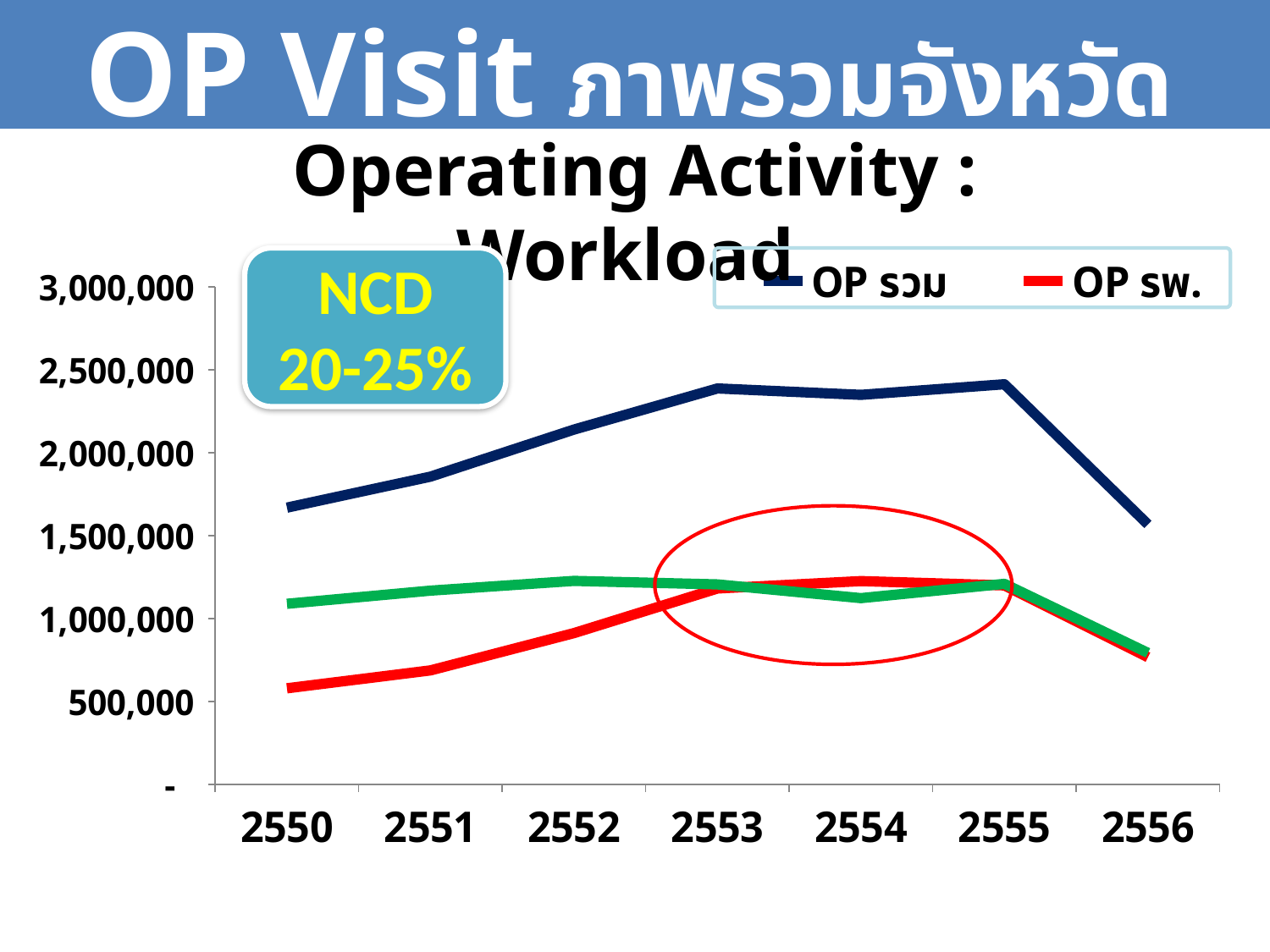
What kind of chart is shown on the slide? line chart Is the value for OP รวม in 2550 greater or less than 1,500,000? greater Is the value for OP รพ. in 2550 greater or less than 1,000,000? less Does the OP รพ. line rise or fall from 2550 to 2553? rise Is the value for OP รวม in 2553 greater or less than 2,000,000? greater In which year is the OP รพ. value lowest? 2550 How many series does the legend list? 2 What colour is the OP รพ. line in the legend? red In 2552, which is larger, OP รวม or OP รพ.? OP รวม How many years are plotted along the x axis? 7